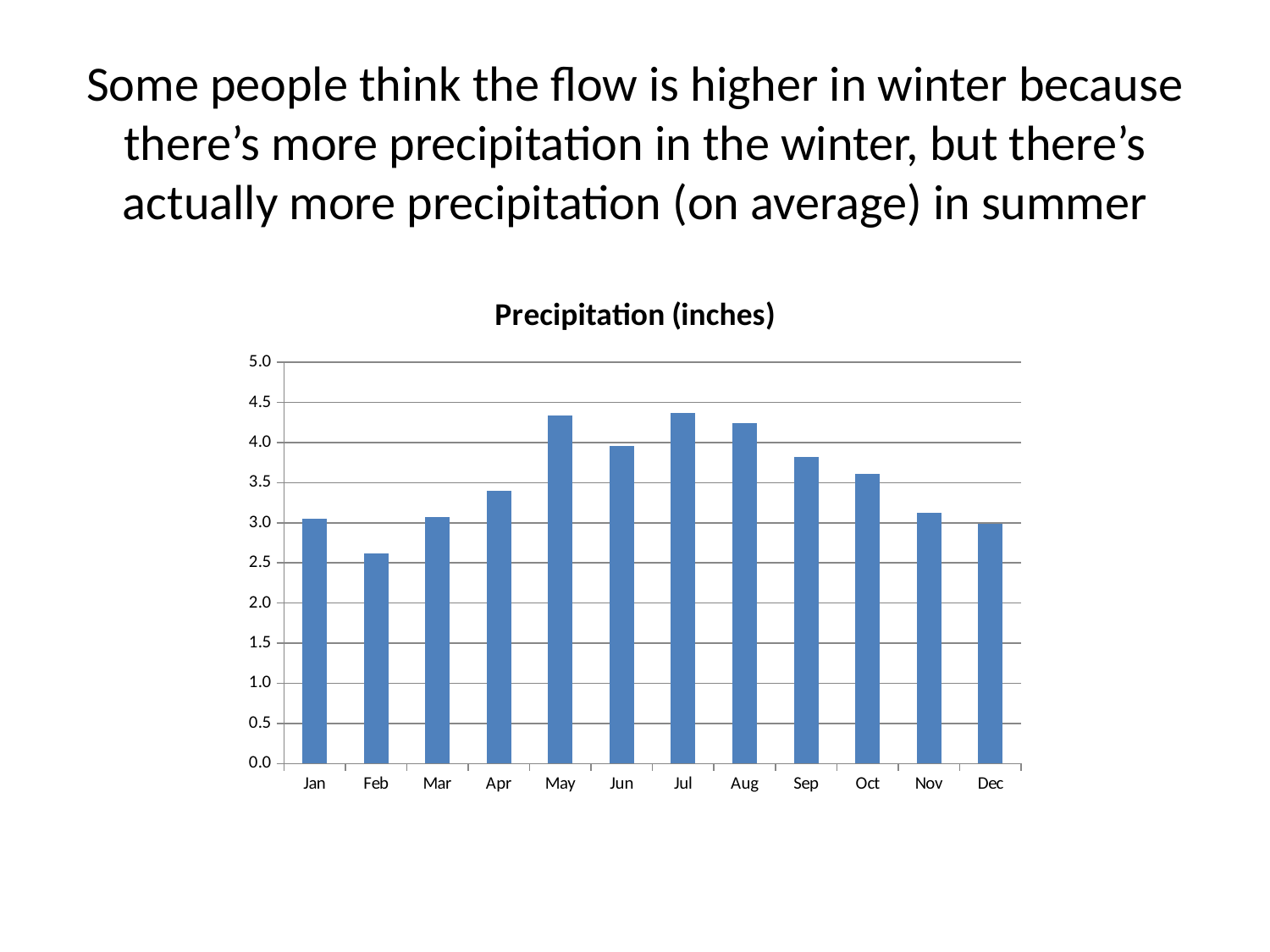
How many months are plotted on the x axis of the chart? 12 What kind of chart is shown on the slide? bar chart Which is larger, the value for Sep or the value for Oct? Sep Is the value for Aug greater or less than 4.0? greater What is the title of the chart? Precipitation (inches) Is the value for May greater or less than 4.0? greater Which is larger, the value for Feb or the value for Jul? Jul Is the value for Feb greater or less than 3.0? less Which month has the lowest precipitation in the chart? Feb Do the values rise or fall from Jul to Dec? fall